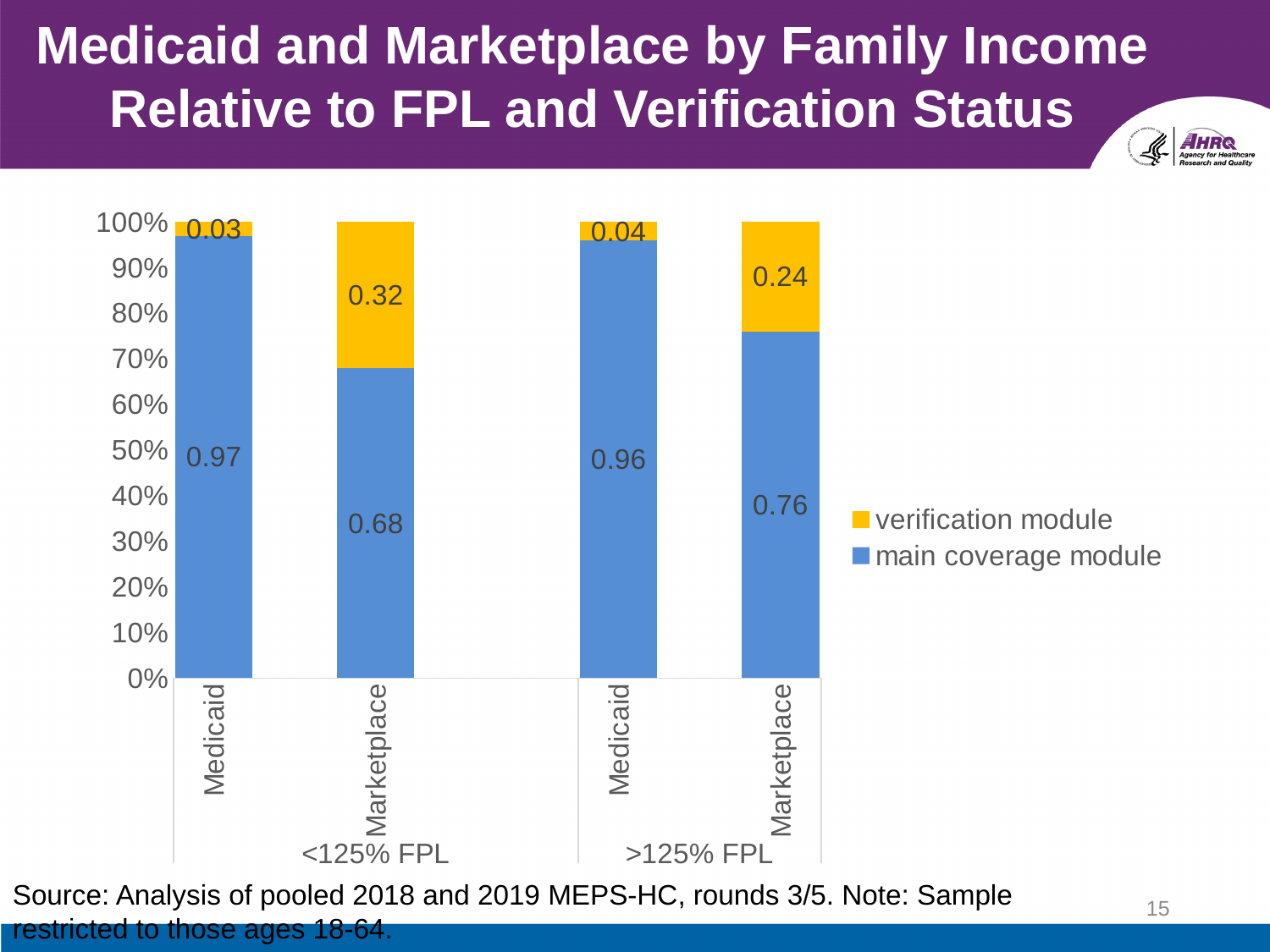
What kind of chart is shown on the slide? Stacked bar chart What is the verification module value for Medicaid in the >125% FPL group? 0.04 Which bar has the highest verification module value? Marketplace, <125% FPL Which bar has the lowest main coverage module value? Marketplace, <125% FPL What is the main coverage module value for Marketplace in the >125% FPL group? 0.76 How many series does the legend list? 2 What is the main coverage module value for Medicaid in the <125% FPL group? 0.97 What is the verification module value for Marketplace in the <125% FPL group? 0.32 How many bars are shown in the chart? 4 Is the main coverage module value larger for Marketplace in the <125% FPL group or in the >125% FPL group? >125% FPL What is the difference between the verification module values for Marketplace in the <125% FPL and >125% FPL groups? 0.08 Which colour represents the verification module series? Yellow